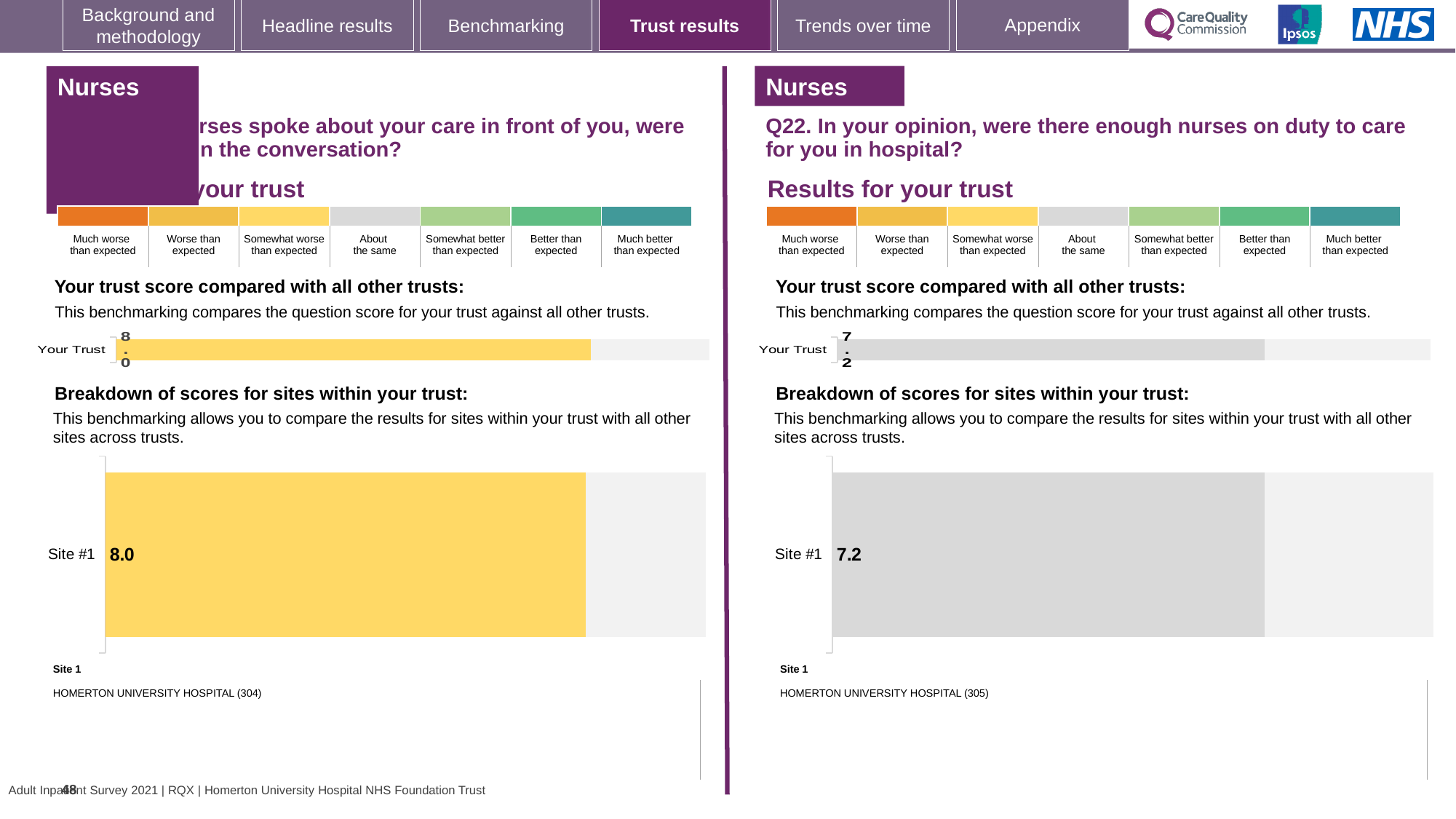
In the left 'Breakdown of scores for sites within your trust' chart, what is the value for Site #1? 8.0 On the left half of the slide, what is the value shown for Your Trust in the 'Your trust score compared with all other trusts' chart? 8.0 What type of chart is used to show the Site #1 score on the right half of the slide (Q22)? Bar chart On the right half of the slide (Q22), what is the value shown for Your Trust in the 'Your trust score compared with all other trusts' chart? 7.2 Which site name is listed as Site 1 under the right (Q22) breakdown chart? HOMERTON UNIVERSITY HOSPITAL (305) What colour is the Site #1 bar in the right (Q22) breakdown chart? Grey Which is larger: the Your Trust score on the left half of the slide or the Your Trust score on the right half (Q22)? Left (8.0) What is the difference between the Site #1 score on the left half of the slide and the Site #1 score on the right half (Q22)? 0.8 How many sites are shown in the left 'Breakdown of scores for sites within your trust' chart? 1 What colour is the Site #1 bar in the left breakdown chart? Yellow How many sites are shown in the right (Q22) 'Breakdown of scores for sites within your trust' chart? 1 In the right (Q22) 'Breakdown of scores for sites within your trust' chart, what is the value for Site #1? 7.2